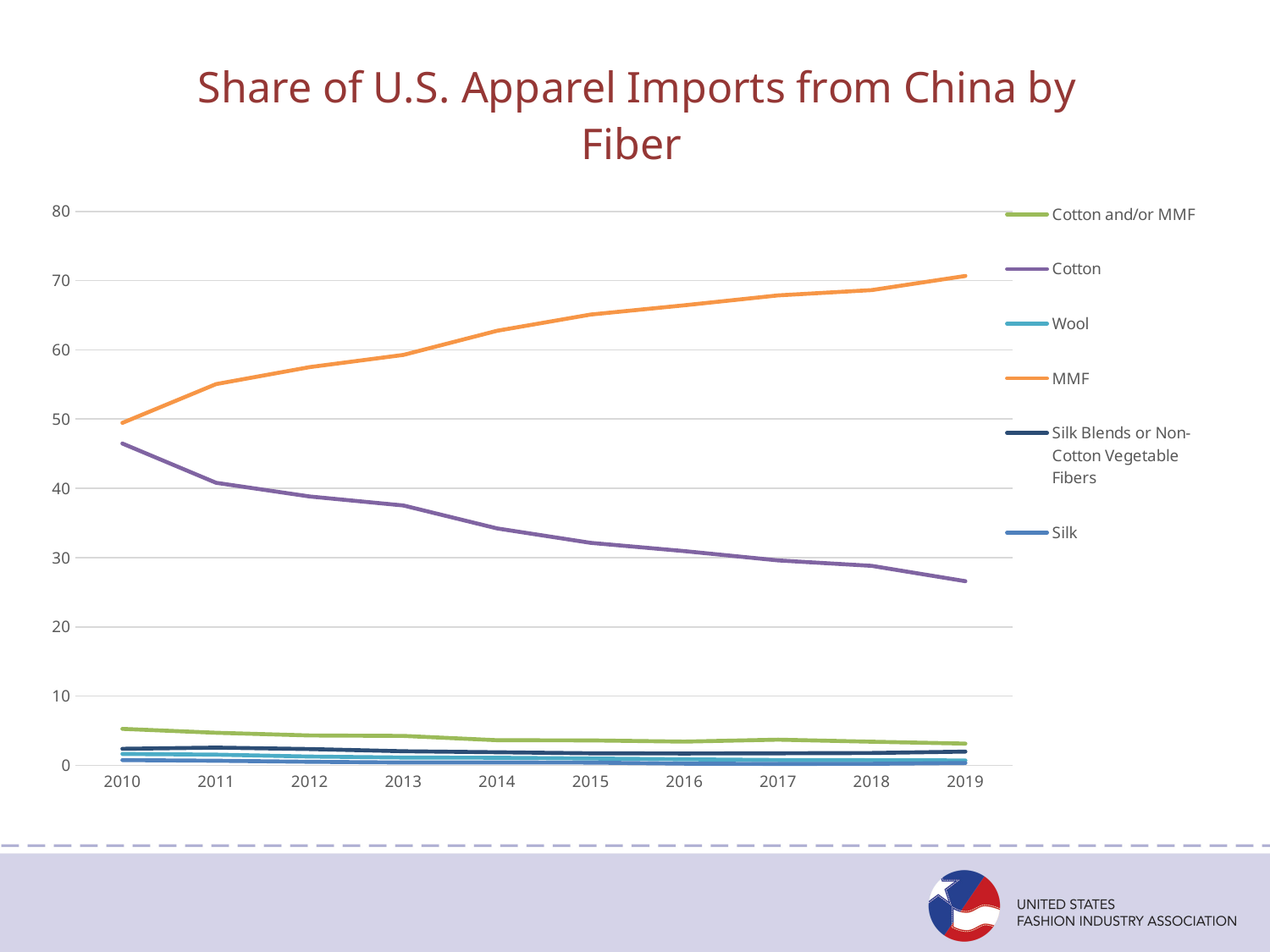
Is the value for Cotton in 2010 greater or less than 40? greater In 2019, which is larger, the value for MMF or the value for Cotton? MMF What kind of chart is shown on the slide? line chart Which series has the highest value in 2019? MMF Is the value for Cotton and/or MMF in 2010 greater or less than 10? less Does the MMF line rise or fall from 2010 to 2019? rise Does the Cotton line rise or fall from 2010 to 2019? fall Is the value for Cotton in 2019 greater or less than 30? less What is the title of the chart? Share of U.S. Apparel Imports from China by Fiber How many series does the legend list? 6 How many years are plotted along the x axis? 10